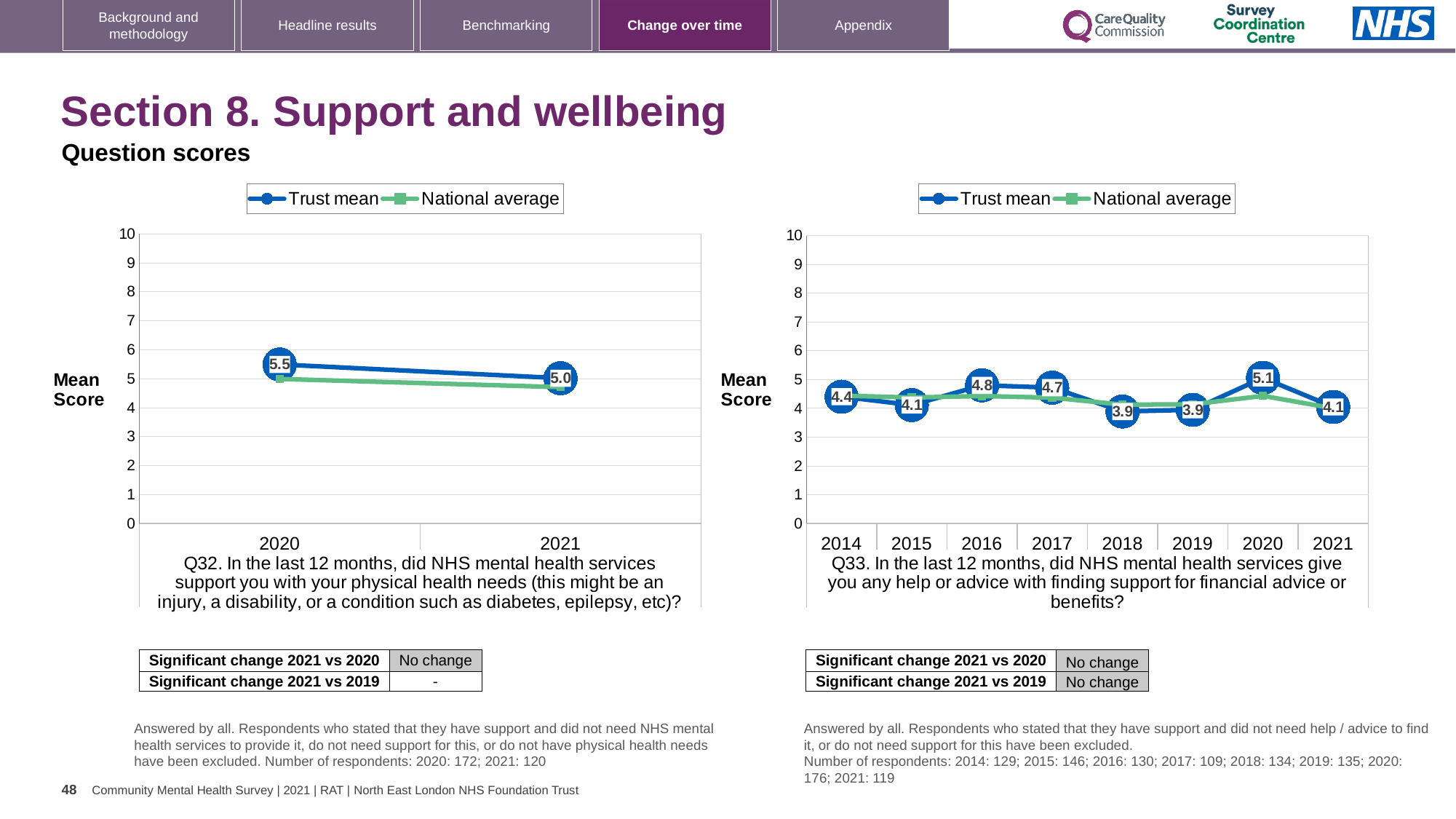
In the Q33 chart on the right, what is the difference between the Trust mean in 2020 and in 2021? 1.0 In the Q33 chart on the right, what is the lowest Trust mean value shown? 3.9 In the Q32 chart on the left, does the Trust mean rise or fall from 2020 to 2021? fall How many series does the legend of the Q32 chart on the left list? 2 In the Q32 chart on the left, by how much did the Trust mean fall from 2020 to 2021? 0.5 In the Q32 chart on the left, what is the Trust mean for 2020? 5.5 In the Q33 chart on the right, is the Trust mean higher in 2017 or in 2018? 2017 In the Q33 chart on the right, what is the Trust mean for 2020? 5.1 In the Q33 chart on the right, what is the Trust mean for 2016? 4.8 How many years are shown on the x axis of the Q33 chart on the right? 8 In the Q33 chart on the right, which year has the highest Trust mean? 2020 In the Q32 chart on the left, what is the Trust mean for 2021? 5.0